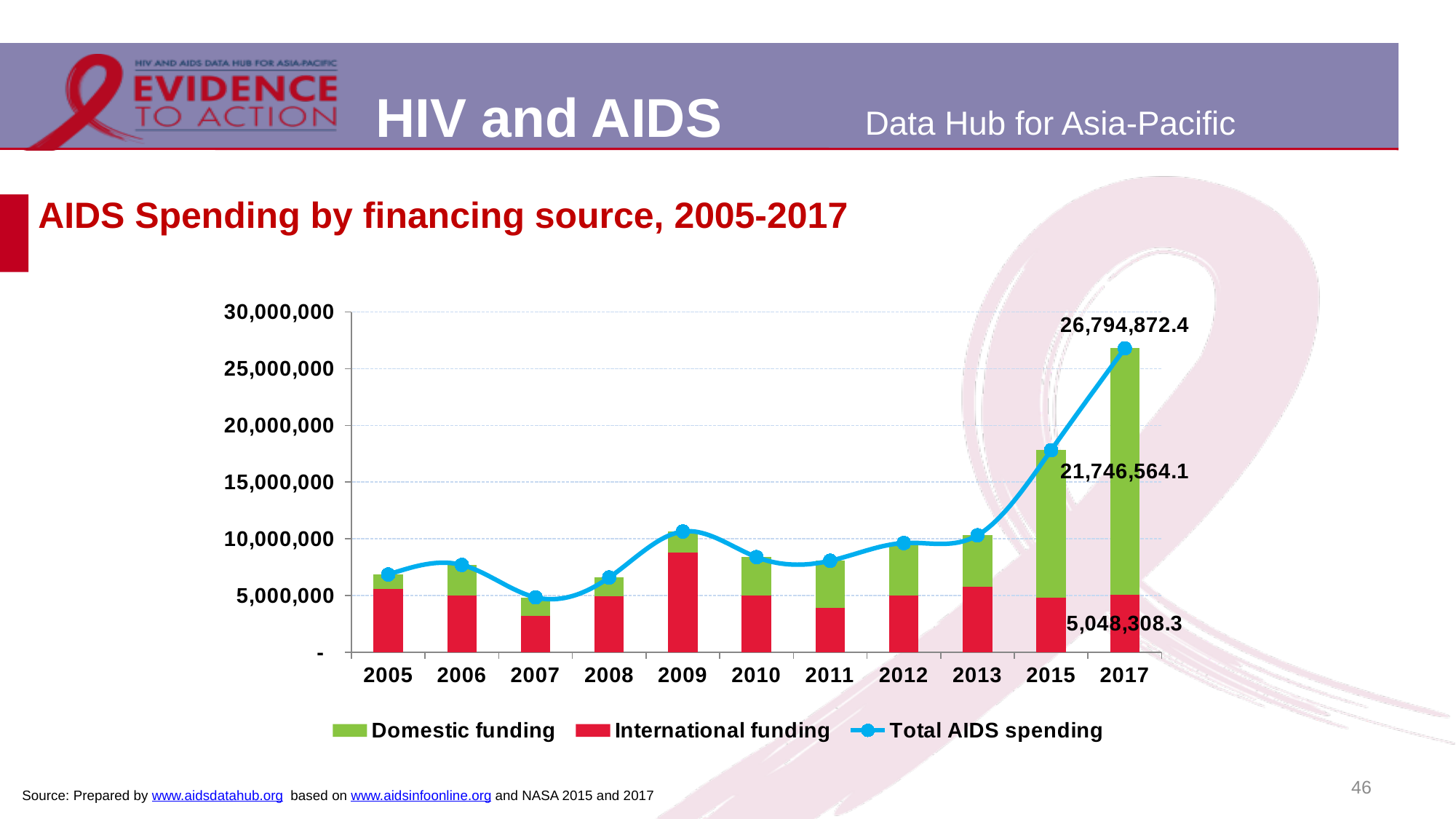
How many series does the legend list? 3 What kind of chart is this? Stacked bar chart with a line What is the Total AIDS spending value labelled for 2017? 26,794,872.4 In which year is Total AIDS spending lowest? 2007 Is the Total AIDS spending for 2015 greater or less than 15,000,000? greater What is the International funding value labelled for 2017? 5,048,308.3 Which year has the larger International funding, 2009 or 2013? 2009 In which year is Total AIDS spending highest? 2017 How many years are shown on the x axis? 11 What is the Domestic funding value labelled for 2017? 21,746,564.1 In 2017, how much larger is Domestic funding than International funding? 16,698,255.8 Is the Total AIDS spending for 2009 greater or less than 10,000,000? greater